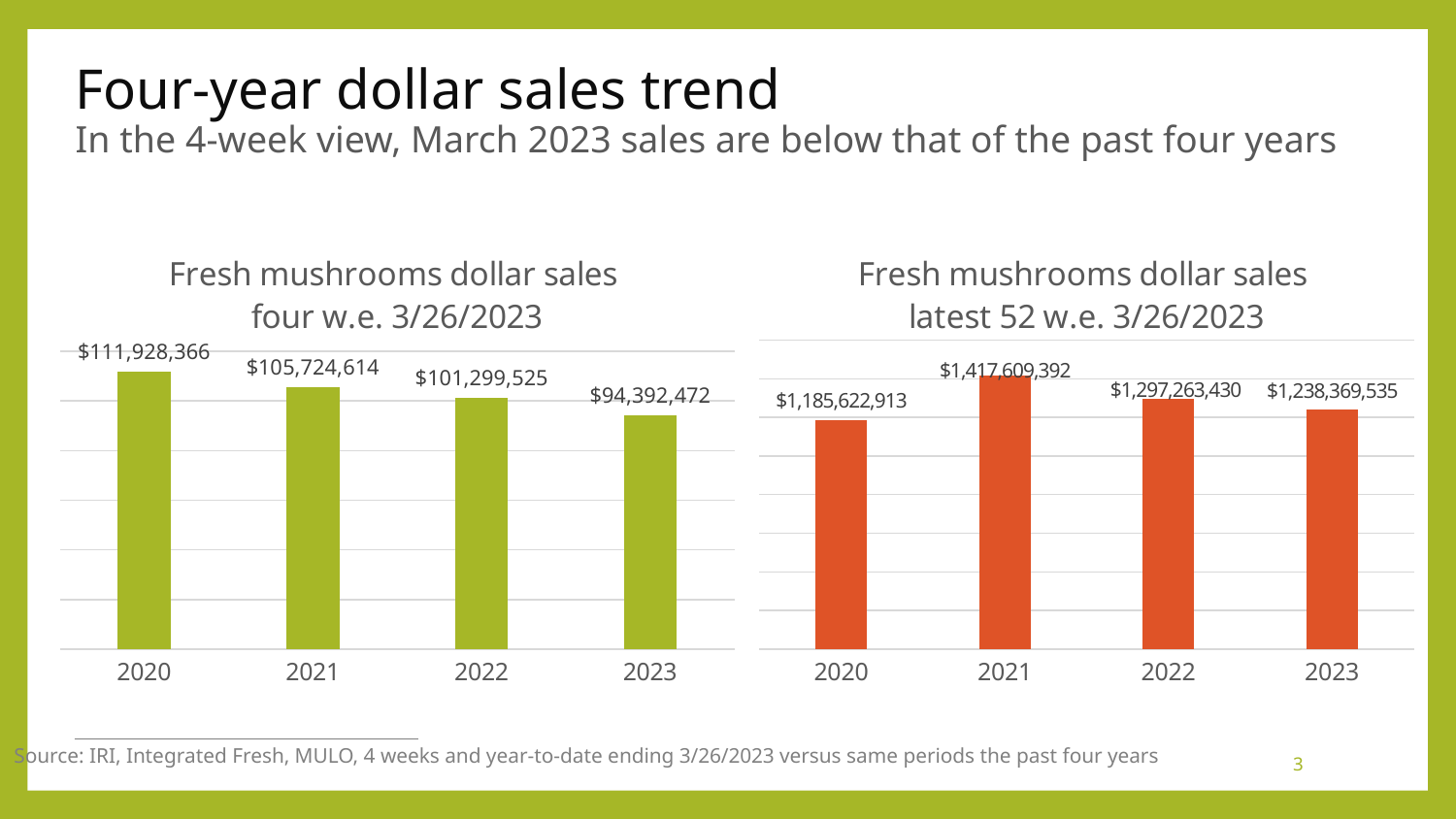
In the 'Fresh mushrooms dollar sales four w.e. 3/26/2023' chart, what is the value for 2020? $111,928,366 In the 'Fresh mushrooms dollar sales four w.e. 3/26/2023' chart, which year has the highest value? 2020 In the 'Fresh mushrooms dollar sales latest 52 w.e. 3/26/2023' chart, what is the value for 2023? $1,238,369,535 In the 'Fresh mushrooms dollar sales four w.e. 3/26/2023' chart, do the values rise or fall from 2020 to 2023? fall In the 'Fresh mushrooms dollar sales latest 52 w.e. 3/26/2023' chart, which year has the highest value? 2021 In the 'Fresh mushrooms dollar sales latest 52 w.e. 3/26/2023' chart, which year has the lowest value? 2020 In the 'Fresh mushrooms dollar sales latest 52 w.e. 3/26/2023' chart, what is the value for 2021? $1,417,609,392 In the 'Fresh mushrooms dollar sales latest 52 w.e. 3/26/2023' chart, which is larger, the value for 2022 or the value for 2023? 2022 In the 'Fresh mushrooms dollar sales four w.e. 3/26/2023' chart, what is the value for 2023? $94,392,472 What kind of chart is the 'Fresh mushrooms dollar sales latest 52 w.e. 3/26/2023' chart? bar chart In the 'Fresh mushrooms dollar sales four w.e. 3/26/2023' chart, what is the difference between the 2020 and 2023 values? $17,535,894 In the 'Fresh mushrooms dollar sales latest 52 w.e. 3/26/2023' chart, what is the difference between the 2021 and 2020 values? $231,986,479